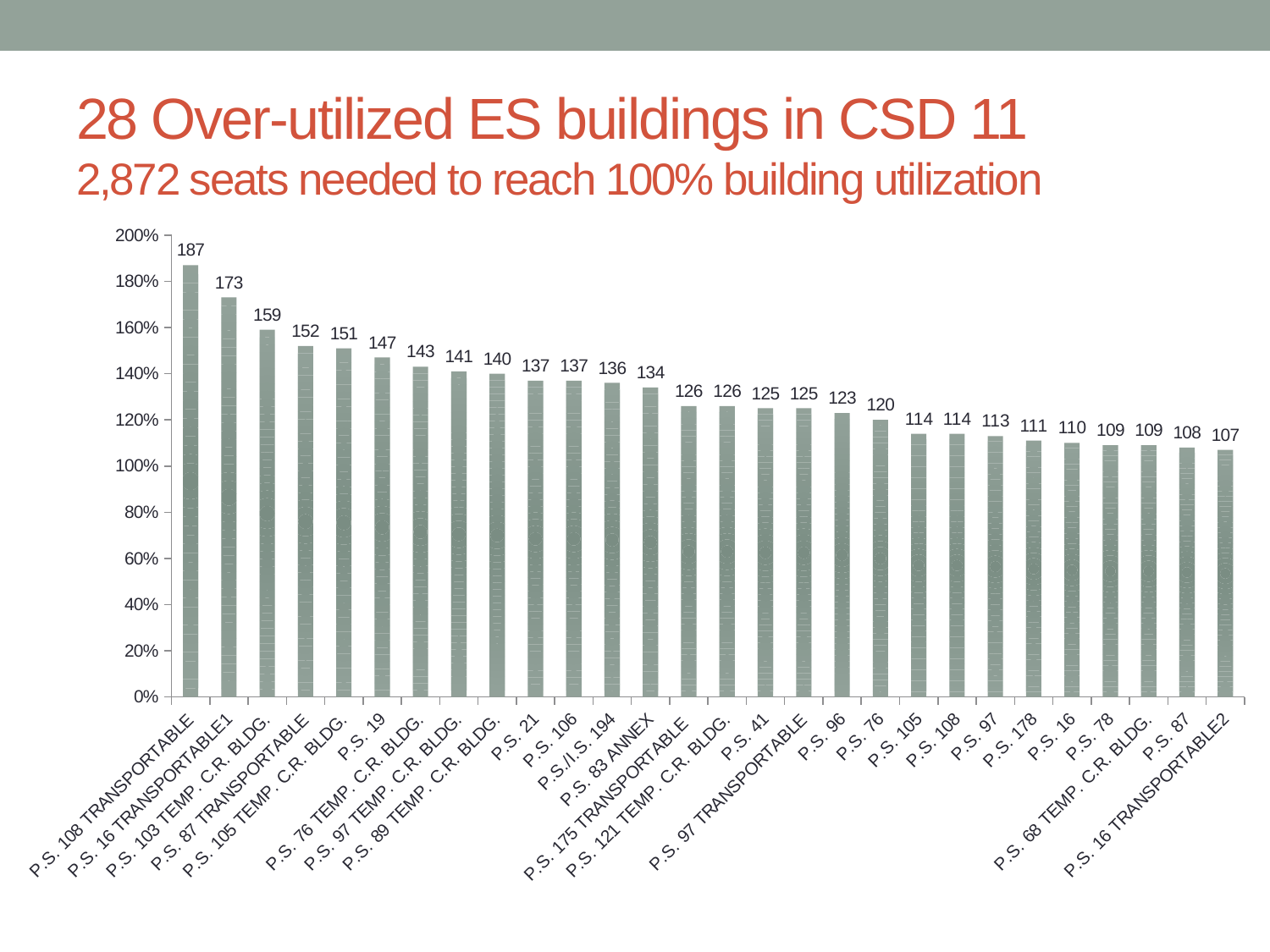
Which building has the lowest value in the chart? P.S. 16 TRANSPORTABLE2 Do the values rise or fall from left to right along the x axis? fall How many buildings (bars) are shown in the chart? 28 What is the value shown for P.S. 83 ANNEX? 134 Which building has the highest value in the chart? P.S. 108 TRANSPORTABLE What is the value shown for P.S. 19? 147 What is the difference between the values for P.S. 108 TRANSPORTABLE and P.S. 16 TRANSPORTABLE1? 14 What kind of chart is shown on the slide? bar chart What is the value shown for P.S. 108 TRANSPORTABLE? 187 Which has a larger value, P.S. 103 TEMP. C.R. BLDG. or P.S. 96? P.S. 103 TEMP. C.R. BLDG. What is the value shown for P.S. 16 TRANSPORTABLE2? 107 Is the value for P.S. 76 greater or less than 140%? less